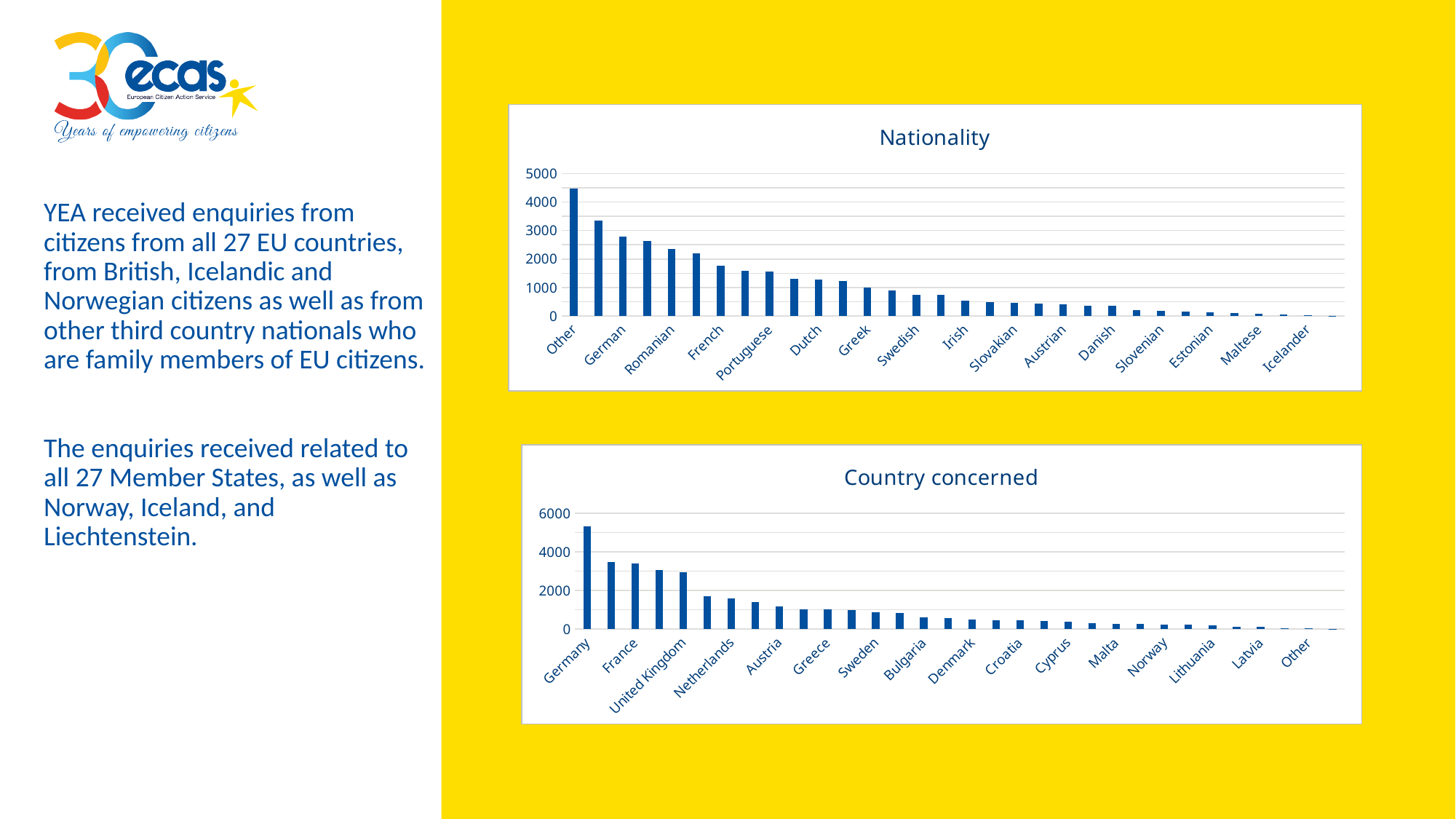
In the 'Nationality' chart, is the value for German greater or less than 3000? less What kind of chart is the 'Nationality' chart? bar chart In the 'Nationality' chart, which is larger, the value for German or the value for Romanian? German In the 'Nationality' chart, which category has the highest value? Other What is the title of the bottom chart on the slide? Country concerned In the 'Country concerned' chart, which category has the highest value? Germany In the 'Country concerned' chart, which is larger, the value for France or the value for Netherlands? France In the 'Nationality' chart, is the value for Portuguese greater or less than 2000? less In the 'Country concerned' chart, is the value for Germany greater or less than 4000? greater In the 'Nationality' chart, do the values rise or fall from left to right along the x axis? fall